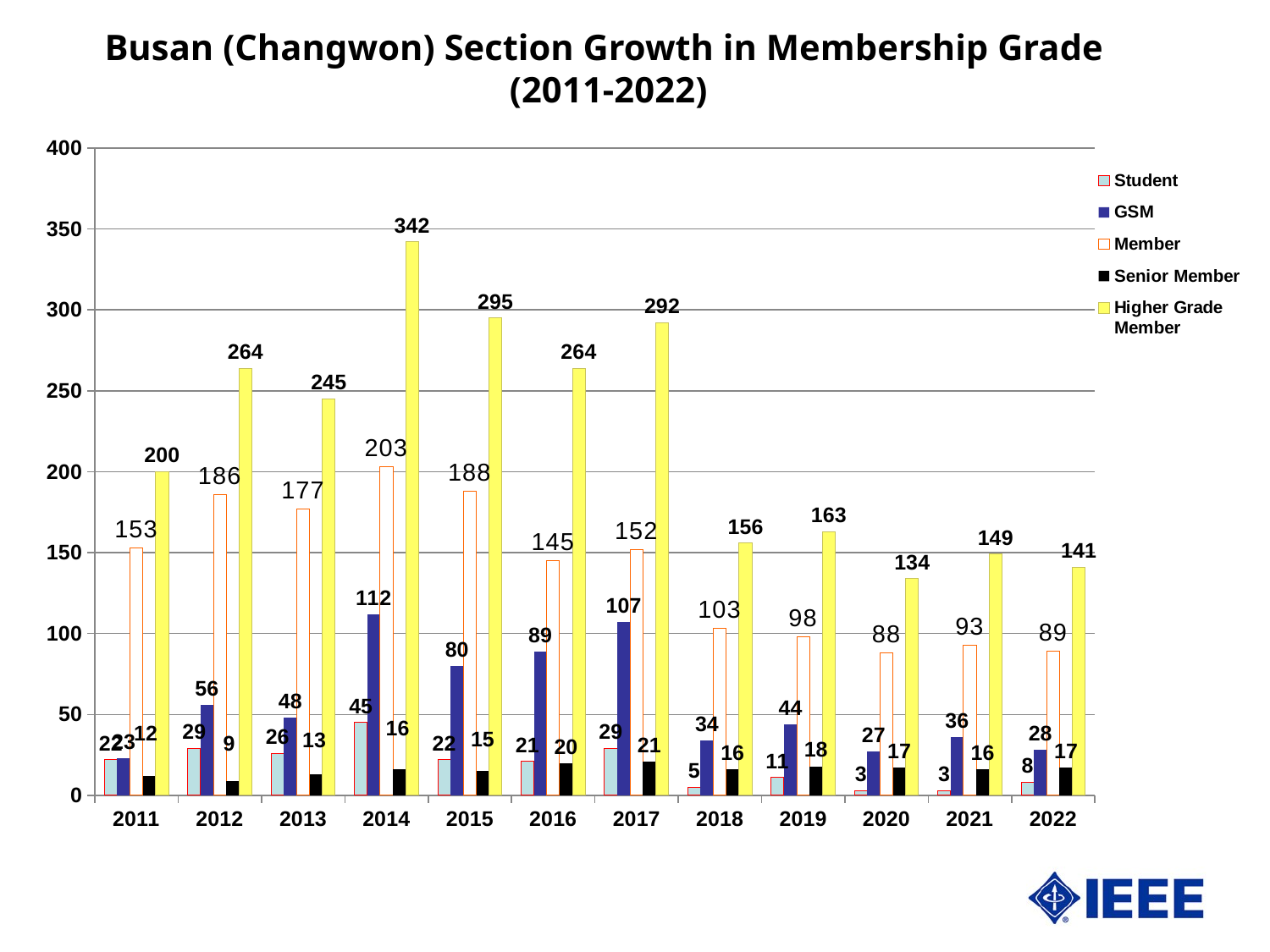
Which is larger, the GSM value for 2016 or the GSM value for 2015? 2016 What kind of chart is shown on the slide? Bar chart In which year is the Member value lowest? 2020 What is the GSM value for 2017? 107 What is the Student value for 2018? 5 In which year is the Higher Grade Member value highest? 2014 How many years are shown on the x axis? 12 What is the Higher Grade Member value for 2014? 342 What is the difference between the Higher Grade Member values for 2014 and 2015? 47 What is the Senior Member value for 2016? 20 What is the Member value for 2012? 186 How many series does the legend list? 5